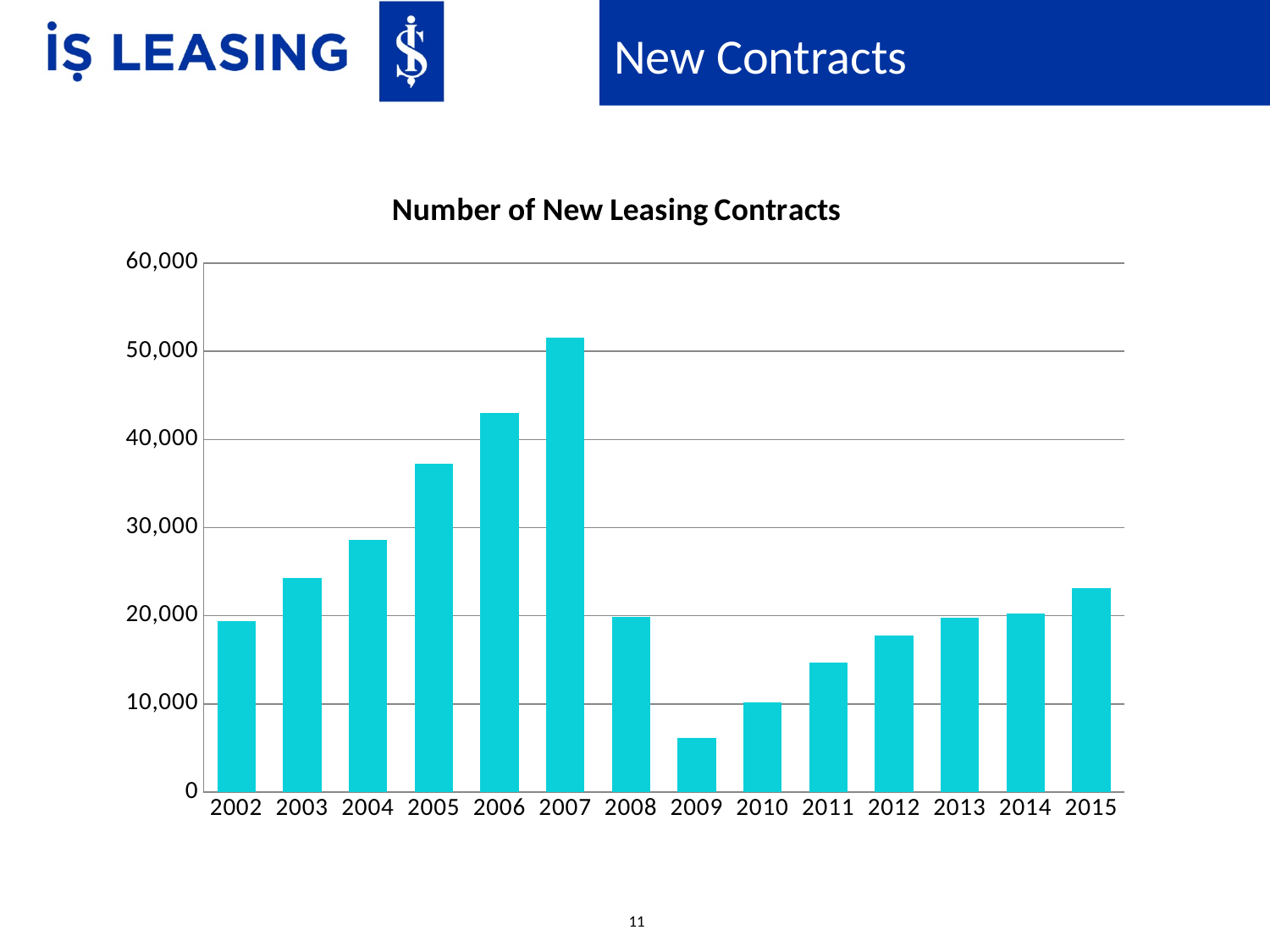
Which year has the lowest number of new leasing contracts? 2009 Which year has more new leasing contracts, 2006 or 2008? 2006 What is the title of the chart? Number of New Leasing Contracts Which year has the highest number of new leasing contracts? 2007 Which year has more new leasing contracts, 2011 or 2012? 2012 Is the value for 2005 greater or less than 40,000? less Is the value for 2009 greater or less than 10,000? less Is the value for 2007 greater or less than 50,000? greater How many years are shown on the x axis of the chart? 14 What type of chart is shown on the slide? Bar chart Do the values rise or fall from 2002 to 2007? rise